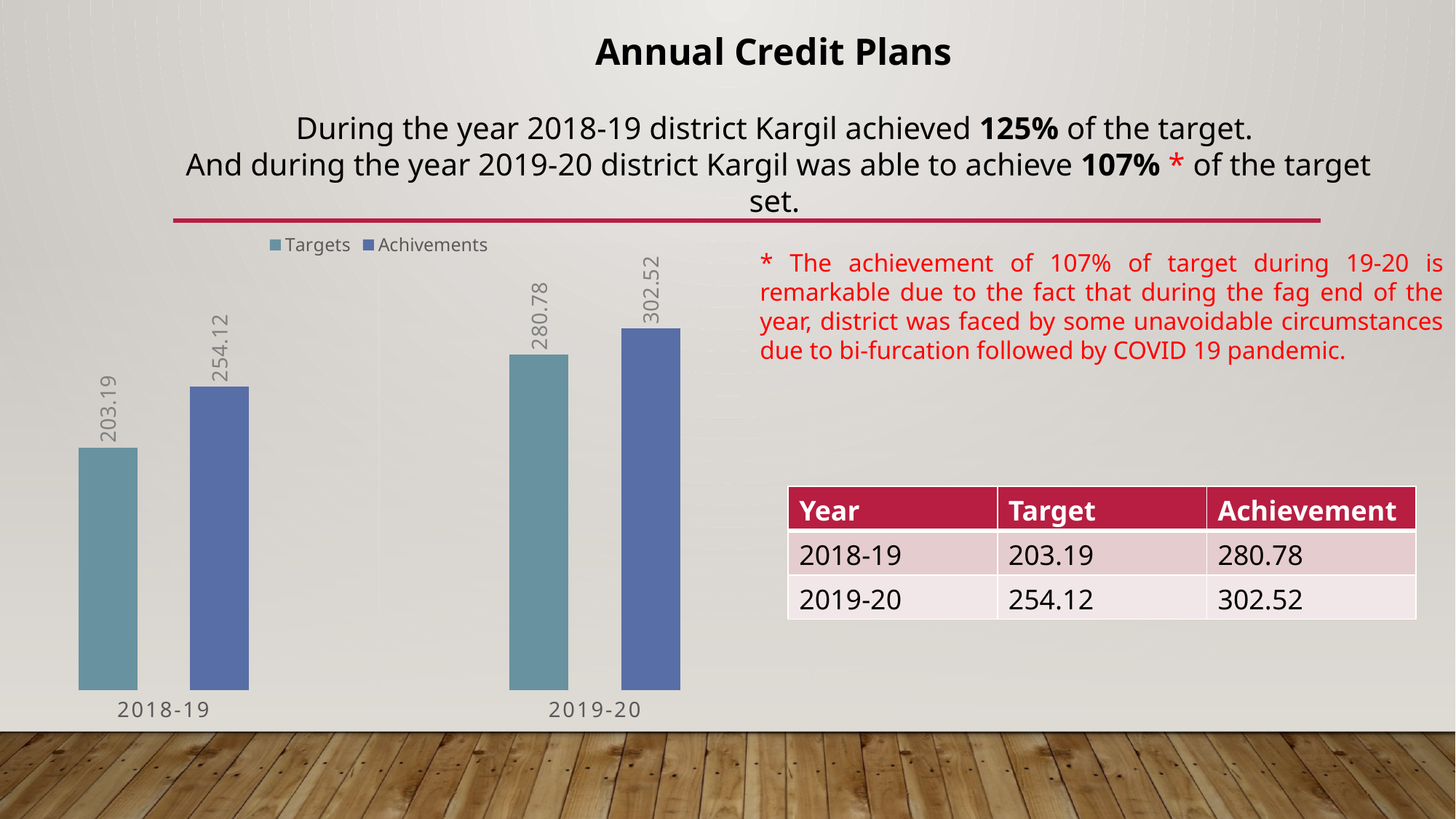
Which bar in the chart has the lowest value? Targets for 2018-19 What is the difference between the Achivements and Targets values for 2018-19 in the chart? 50.93 What is the Achivements value for 2019-20 in the chart? 302.52 How many series does the chart legend list? 2 What is the Targets value for 2018-19 in the chart? 203.19 How many year categories are shown on the x axis of the chart? 2 What is the Targets value for 2019-20 in the chart? 280.78 Which bar in the chart has the highest value? Achivements for 2019-20 What type of chart is shown on the slide? bar chart What is the Achivements value for 2018-19 in the chart? 254.12 What is the difference between the Targets values for 2019-20 and 2018-19 in the chart? 77.59 In the chart, is the Targets value for 2019-20 larger or smaller than the Achivements value for 2018-19? larger